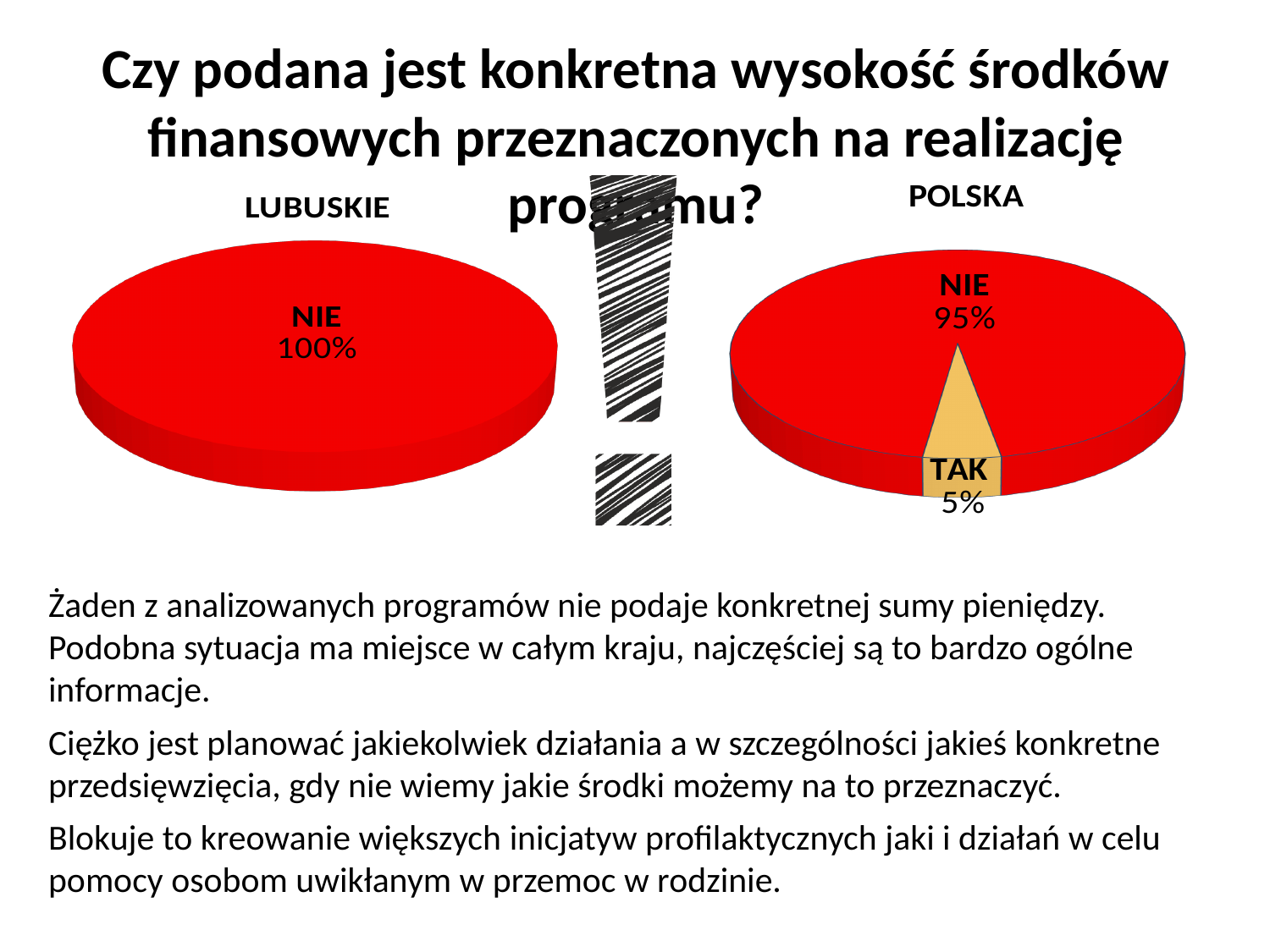
In the POLSKA chart, what is the difference in percentage points between NIE and TAK? 90 In the POLSKA chart, which category has the smallest share? TAK How many slices does the LUBUSKIE chart have? 1 In the POLSKA chart, what colour is the TAK slice? yellow In the POLSKA chart, what percentage is shown for NIE? 95% How many slices does the POLSKA chart have? 2 In the POLSKA chart, which category has the largest share? NIE What kind of chart is the LUBUSKIE chart? pie chart What is the title of the chart on the left? LUBUSKIE In the POLSKA chart, which is larger, NIE or TAK? NIE In the LUBUSKIE chart, what percentage is shown for NIE? 100% In the POLSKA chart, what percentage is shown for TAK? 5%